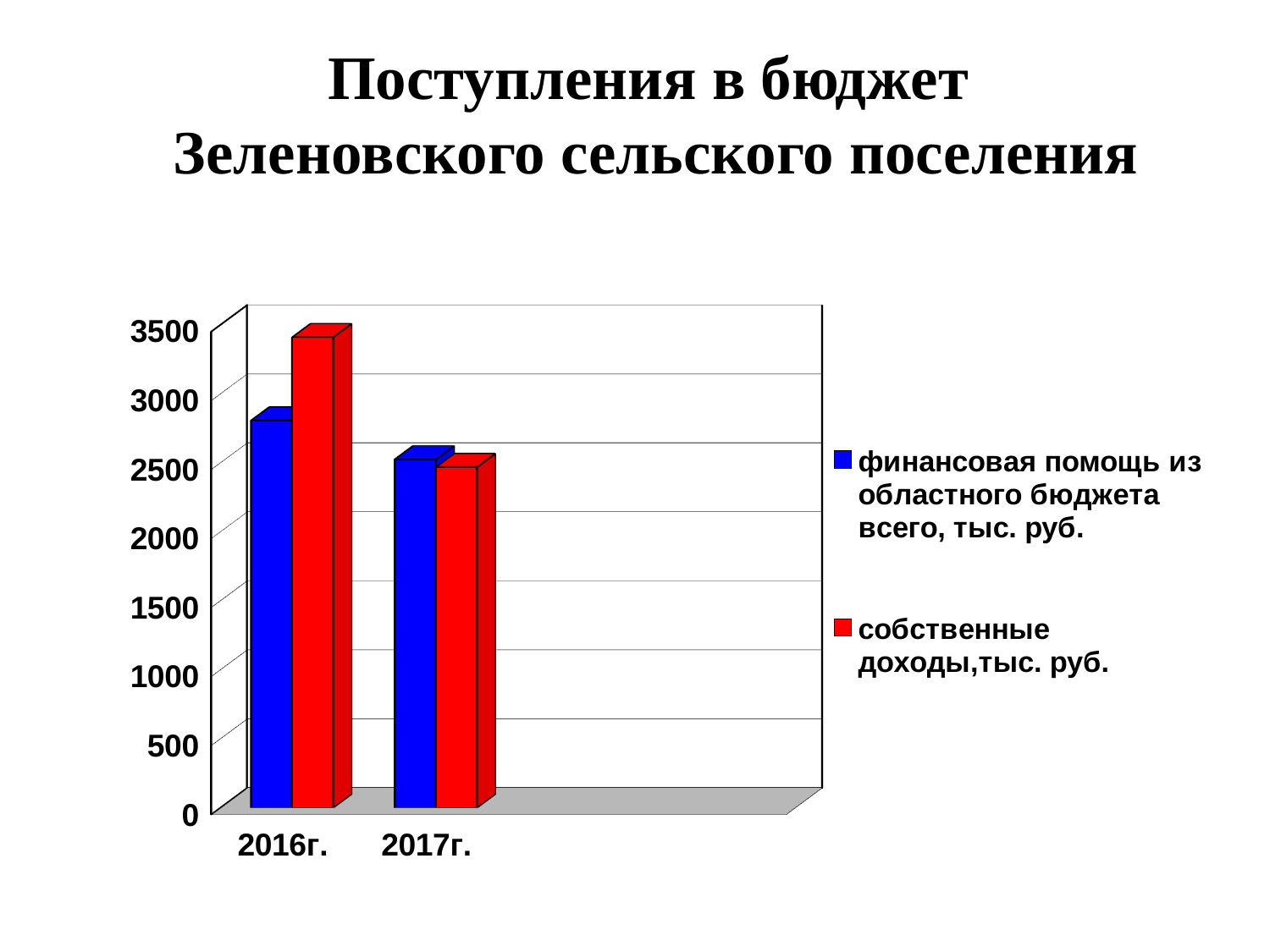
Which bar is the highest on the chart? собственные доходы in 2016г. Is the value for "собственные доходы" in 2016г. greater or less than 3000? greater Is the value for "собственные доходы" in 2017г. greater or less than 2000? greater How many categories (years) are shown on the x axis? 2 What is the title of the chart on the slide? Поступления в бюджет Зеленовского сельского поселения Is the value for "финансовая помощь из областного бюджета" in 2016г. greater or less than 3000? less In 2016г., which is larger: "финансовая помощь из областного бюджета" or "собственные доходы"? собственные доходы Which colour represents the series "собственные доходы,тыс. руб."? red What kind of chart is shown on the slide? bar chart Do the values for "собственные доходы" rise or fall from 2016г. to 2017г.? fall How many series does the legend list? 2